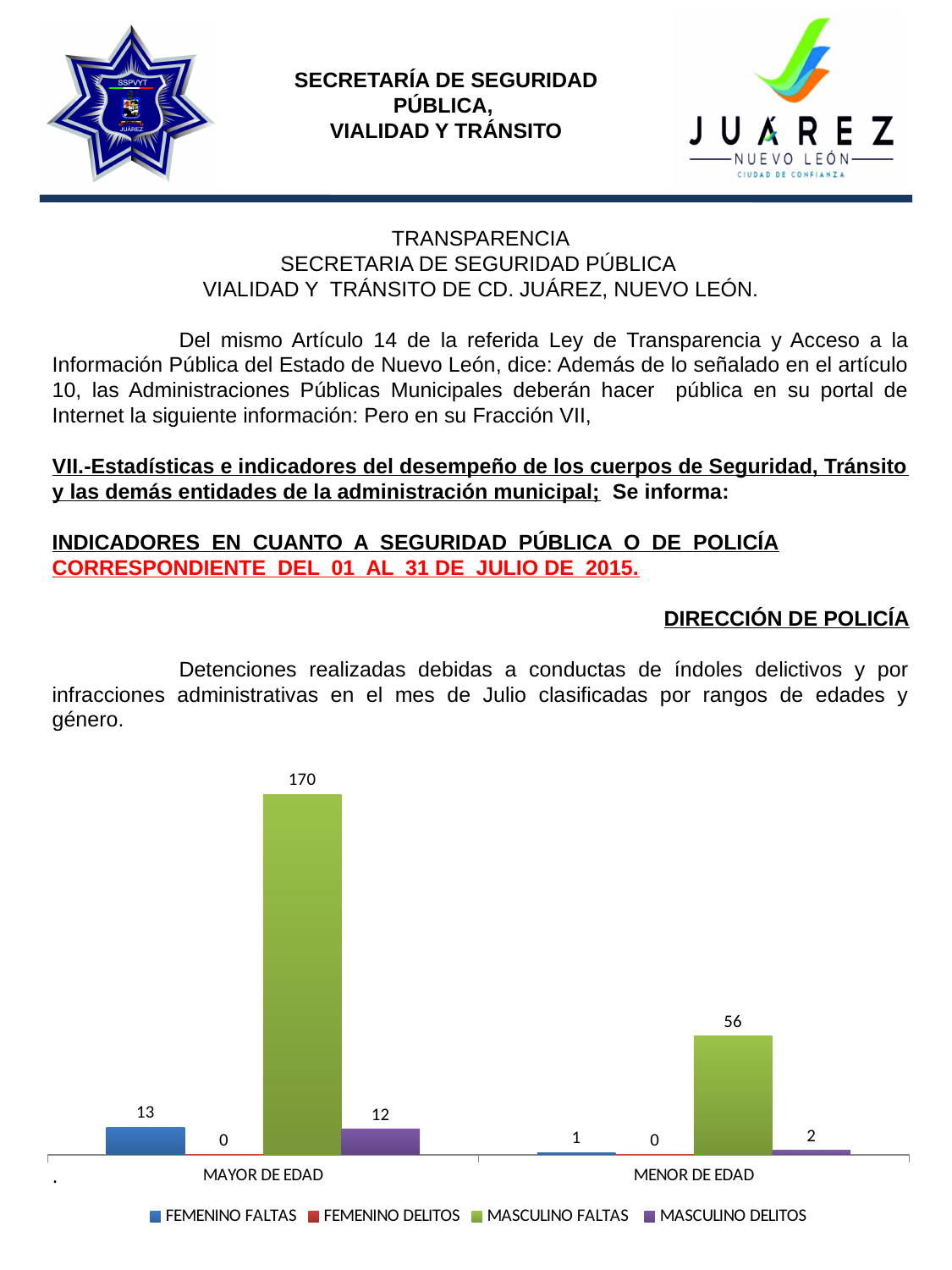
Which is larger: FEMENINO FALTAS for MAYOR DE EDAD or MASCULINO DELITOS for MAYOR DE EDAD? FEMENINO FALTAS for MAYOR DE EDAD How many categories are shown on the x axis of the chart? 2 How many series does the chart legend list? 4 What is the value for MASCULINO DELITOS in the MAYOR DE EDAD category? 12 What is the value for MASCULINO FALTAS in the MAYOR DE EDAD category? 170 What colour represents MASCULINO FALTAS in the chart legend? Green What is the value for FEMENINO DELITOS in the MENOR DE EDAD category? 0 What is the value for FEMENINO FALTAS in the MENOR DE EDAD category? 1 Which category has the lower value for MASCULINO DELITOS? MENOR DE EDAD What is the difference between MASCULINO FALTAS for MAYOR DE EDAD and MASCULINO FALTAS for MENOR DE EDAD? 114 Which series has the highest value in the MENOR DE EDAD category? MASCULINO FALTAS What kind of chart is shown on the slide? Bar chart